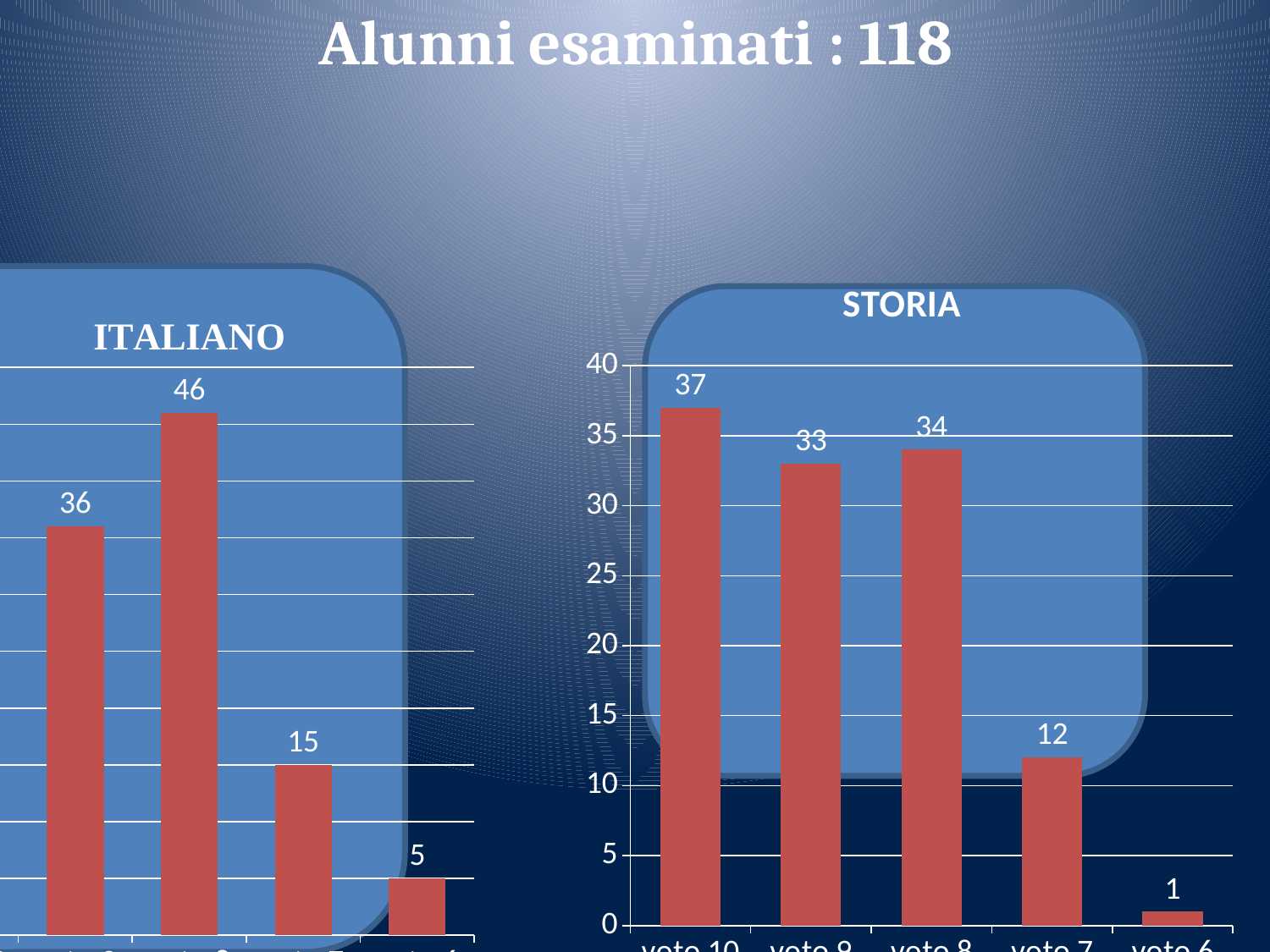
In the STORIA chart, which category has the lowest value? voto 6 In the STORIA chart, which is larger, the value for voto 8 or the value for voto 7? voto 8 What kind of chart is the ITALIANO chart? bar chart In the STORIA chart, what is the value for voto 10? 37 In the STORIA chart, which category has the highest value? voto 10 In the ITALIANO chart, what is the highest value shown on a bar? 46 In the STORIA chart, what is the value for voto 6? 1 What is the title of the chart on the right side of the slide? STORIA In the STORIA chart, what is the difference between the values for voto 10 and voto 9? 4 In the STORIA chart, what is the value for voto 7? 12 In the STORIA chart, how many categories are shown? 5 In the ITALIANO chart, what is the difference between the highest and lowest bar values? 41